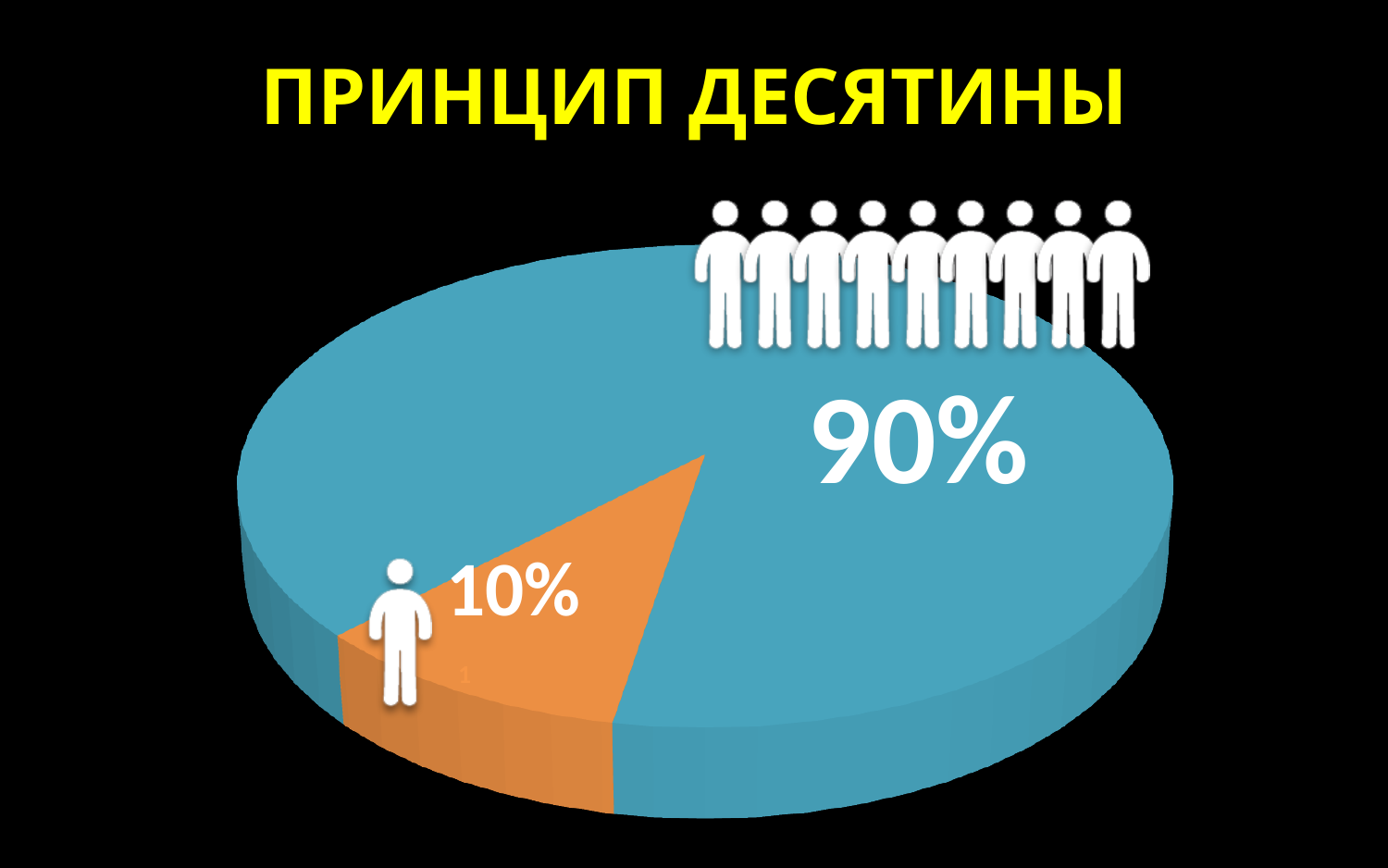
What kind of chart is shown on the slide? Pie chart What share of the pie does the orange slice represent? 10% Which is larger, the blue slice or the orange slice? The blue slice Is the share of the orange slice greater or less than 50%? less How many slices does the pie chart have? 2 What colour is the slice labelled 10%? Orange Which slice of the pie chart is the largest? The blue slice (90%) What is the total of the two slice percentages shown on the pie chart? 100% What is the title of the slide containing the pie chart? ПРИНЦИП ДЕСЯТИНЫ What share of the pie does the blue slice represent? 90% Which slice of the pie chart is the smallest? The orange slice (10%) What is the difference in percentage points between the blue slice and the orange slice? 80 percentage points